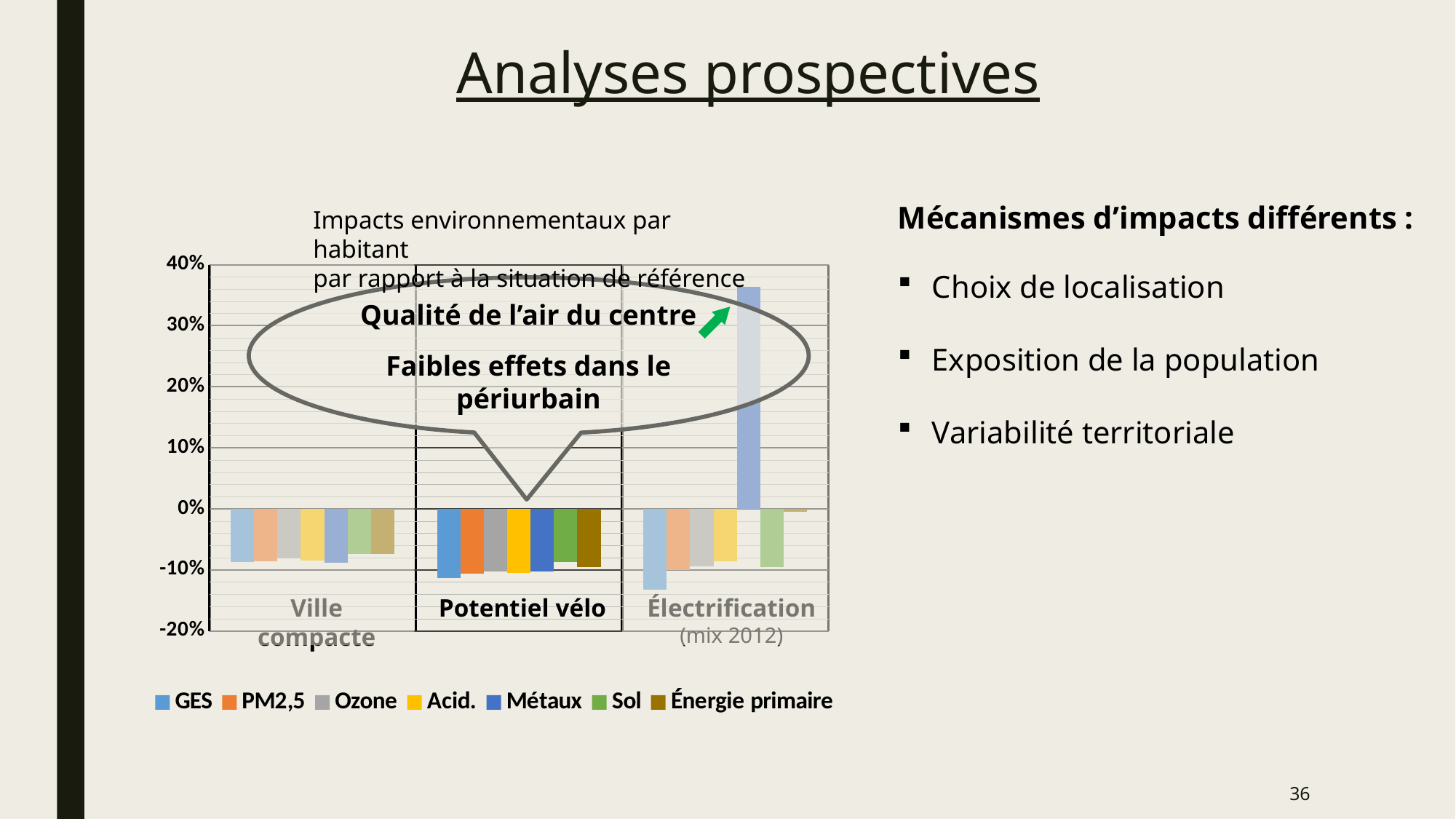
How many series does the chart legend list? 7 Is the value for GES in the Ville compacte category greater or less than -10%? greater Which series has the lowest value in the Électrification (mix 2012) category? GES How many categories are shown on the x axis of the chart? 3 Which is larger: the Énergie primaire value for Potentiel vélo or the Énergie primaire value for Électrification (mix 2012)? Électrification (mix 2012) Which series is listed first in the chart legend? GES Is the value for GES in the Électrification (mix 2012) category greater or less than -10%? less What kind of chart is shown on the slide? bar chart Which series has the highest value in the Électrification (mix 2012) category? Métaux Is the value for Métaux in the Électrification (mix 2012) category greater or less than 30%? greater Which is larger: the Métaux value for Ville compacte or the Métaux value for Électrification (mix 2012)? Électrification (mix 2012) Which category contains the tallest positive bar in the chart? Électrification (mix 2012)